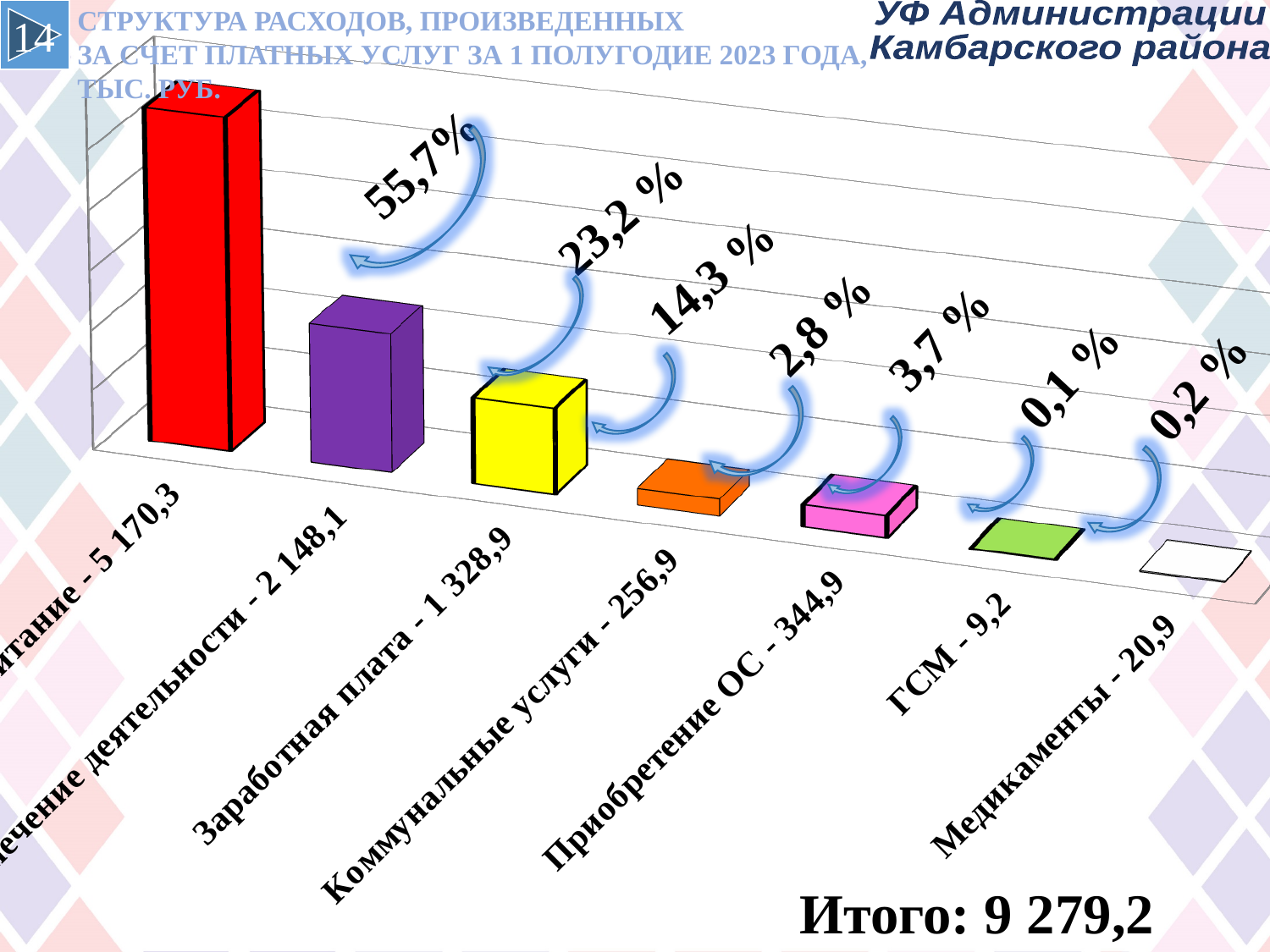
What is the value of the tallest (red) bar? 5 170,3 What is the difference between Приобретение ОС and Коммунальные услуги? 88,0 What is the value for Коммунальные услуги? 256,9 What is the value for ГСМ? 9,2 What percentage share is shown for Заработная плата? 14,3 % What percentage share is shown for Приобретение ОС? 3,7 % What is the value for Приобретение ОС? 344,9 What total (Итого) is shown on the slide? 9 279,2 What is the value for Медикаменты? 20,9 Which is larger, Медикаменты or ГСМ? Медикаменты Which category has the lowest value? ГСМ What is the value for Заработная плата? 1 328,9